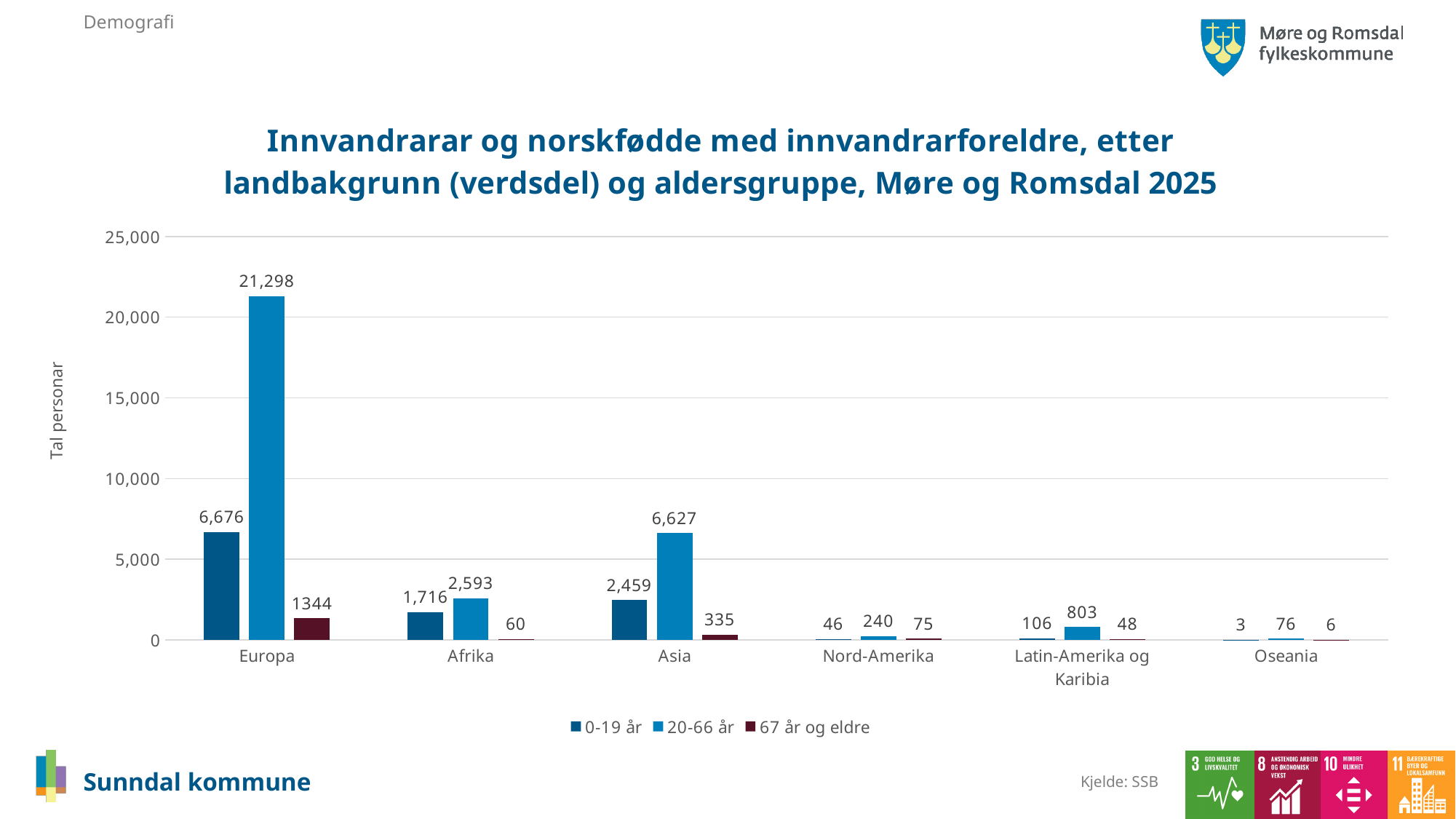
What is the value for the 20-66 år series for Europa? 21,298 What is the value for the 67 år og eldre series for Asia? 335 How many series does the legend list? 3 What is the difference between the 20-66 år value and the 0-19 år value for Asia? 4,168 Which category has the highest value in the 20-66 år series? Europa Is the 20-66 år value for Europa greater or less than 20,000? greater Which category has the lowest value in the 0-19 år series? Oseania Which is larger: the 0-19 år value for Europa or the 20-66 år value for Asia? 0-19 år value for Europa What is the label of the y axis? Tal personar How many categories (world regions) are shown on the x axis? 6 What kind of chart is shown on the slide? Bar chart What is the value for the 0-19 år series for Latin-Amerika og Karibia? 106